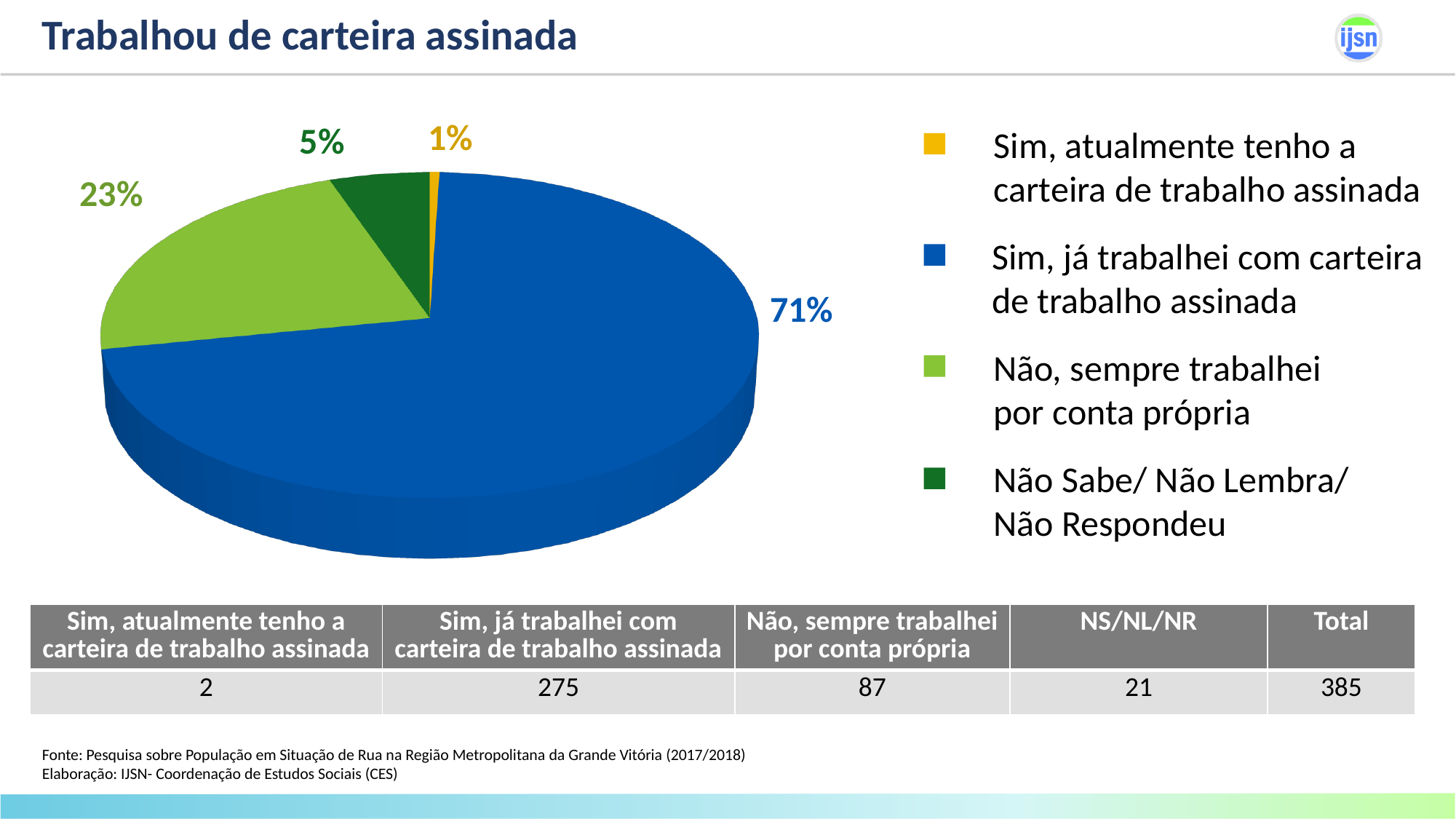
What kind of chart is shown on the slide? Pie chart How many slices does the pie chart have? 4 Which category has the largest slice of the pie? Sim, já trabalhei com carteira de trabalho assinada Which is larger: the slice for 'Não, sempre trabalhei por conta própria' or the slice for 'Não Sabe/ Não Lembra/ Não Respondeu'? Não, sempre trabalhei por conta própria Which category has the smallest slice of the pie? Sim, atualmente tenho a carteira de trabalho assinada What percentage of the pie is 'Sim, já trabalhei com carteira de trabalho assinada'? 71% What is the title of the chart? Trabalhou de carteira assinada What is the difference in percentage points between 'Sim, já trabalhei com carteira de trabalho assinada' and 'Não, sempre trabalhei por conta própria'? 48 percentage points What percentage of the pie is 'Sim, atualmente tenho a carteira de trabalho assinada'? 1% What percentage of the pie is 'Não Sabe/ Não Lembra/ Não Respondeu'? 5% What percentage of the pie is 'Não, sempre trabalhei por conta própria'? 23% What colour is the slice for 'Sim, atualmente tenho a carteira de trabalho assinada'? Yellow